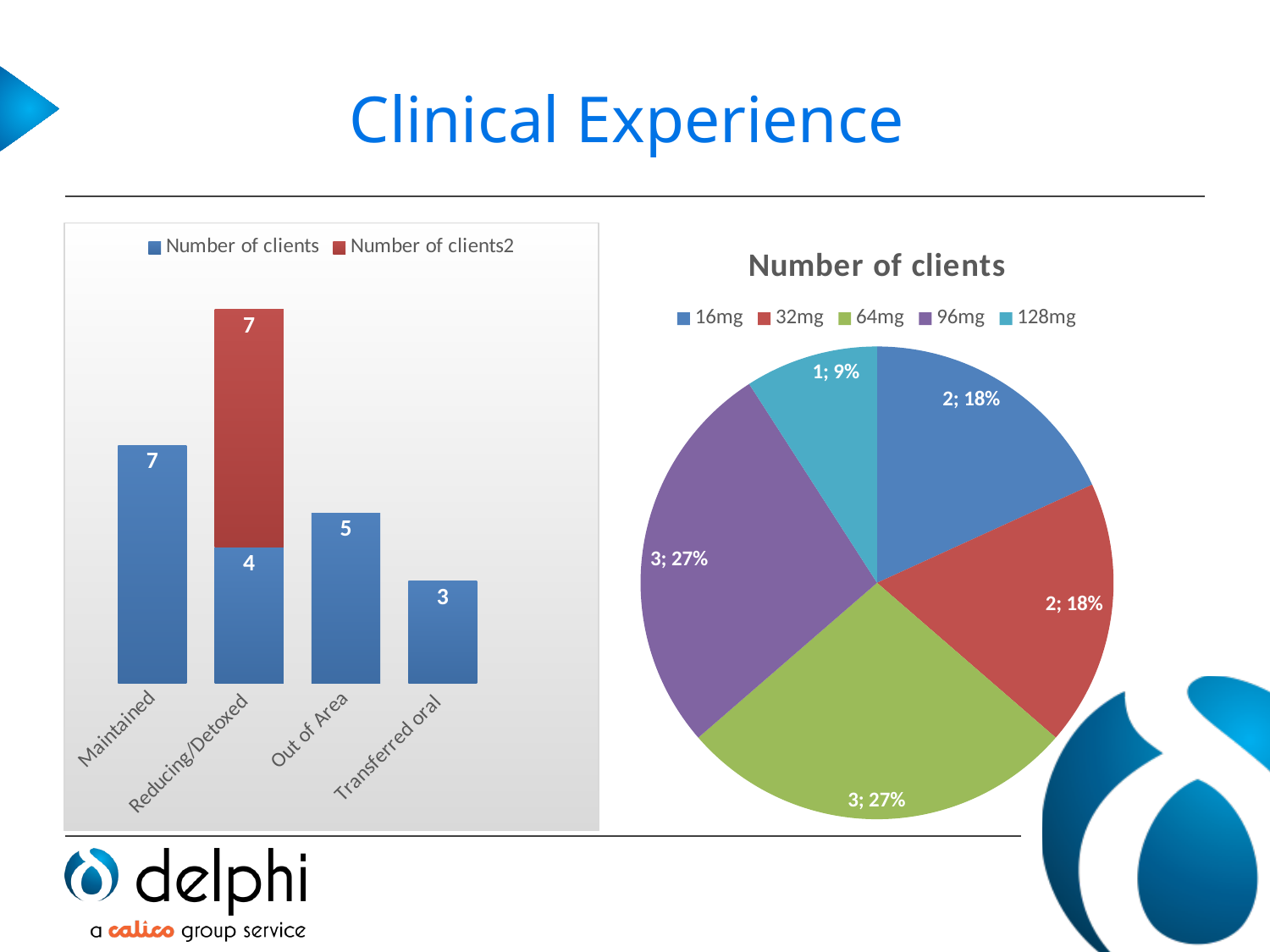
What kind of chart is the 'Number of clients' chart on the right? Pie chart In the bar chart on the left, what is the total of the stacked bar for Reducing/Detoxed? 11 In the bar chart on the left, what is the Number of clients value for Maintained? 7 In the 'Number of clients' pie chart, what is the value for 64mg? 3 In the bar chart on the left, what is the difference between the Number of clients values for Maintained and Transferred oral? 4 In the bar chart on the left, how many series does the legend list? 2 In the 'Number of clients' pie chart, how many slices does the legend list? 5 In the bar chart on the left, which category has the lowest Number of clients value? Transferred oral In the bar chart on the left, what is the Number of clients2 value for Reducing/Detoxed? 7 In the 'Number of clients' pie chart, what share does the 128mg slice represent? 9% In the bar chart on the left, how many categories are shown on the x axis? 4 In the bar chart on the left, what is the Number of clients value for Out of Area? 5